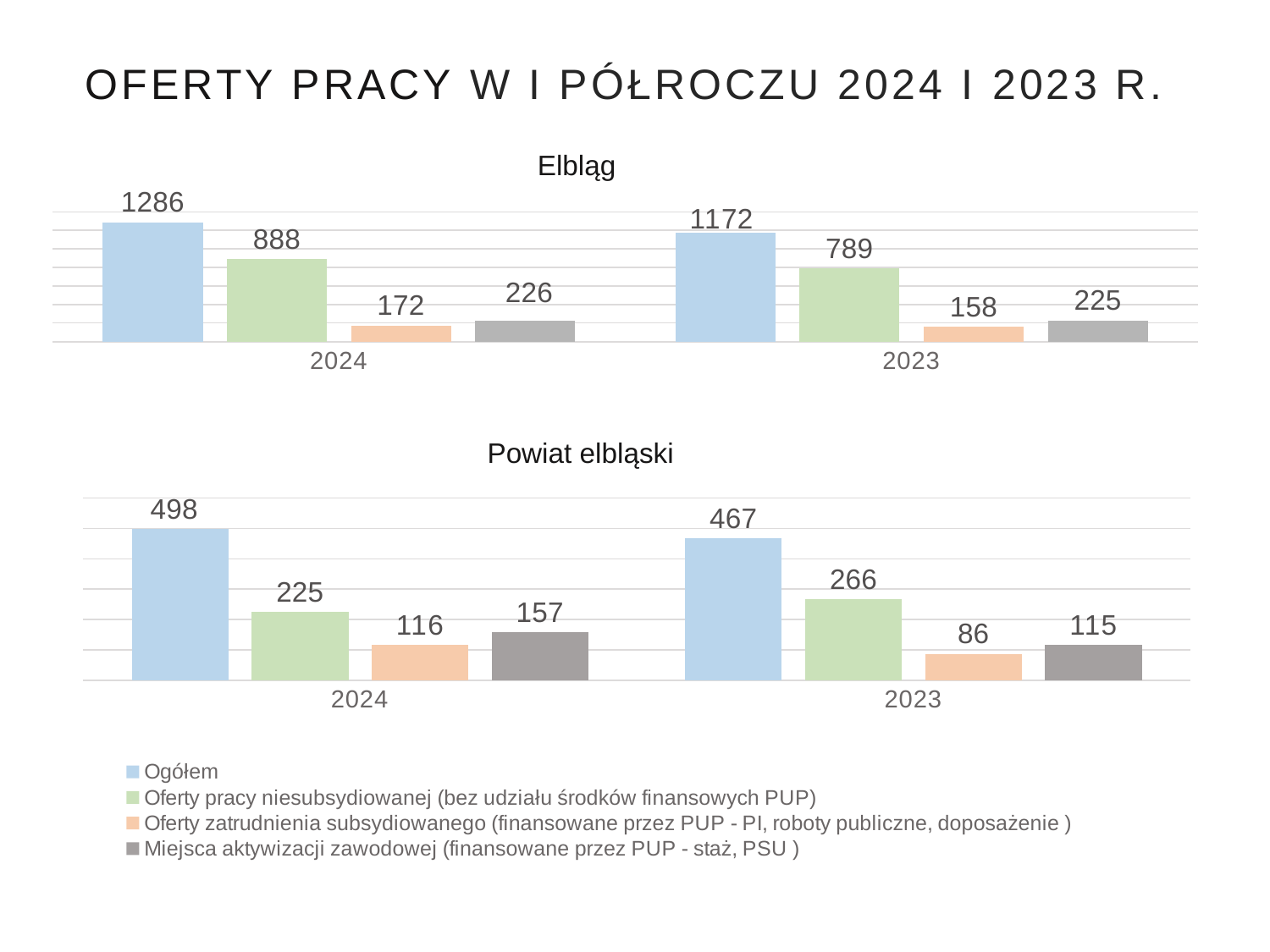
What is the title of the top chart? Elbląg In the Elbląg chart, is Miejsca aktywizacji zawodowej larger in 2024 or in 2023? 2024 How many series does the legend list? 4 In the Elbląg chart, what is the value of Ogółem for 2024? 1286 In the Elbląg chart, what is the difference between Ogółem in 2024 and Ogółem in 2023? 114 In the Powiat elbląski chart, what is the difference between Oferty pracy niesubsydiowanej in 2023 and in 2024? 41 In the Powiat elbląski chart, which series has the highest value in 2024? Ogółem In the Elbląg chart, what is the value of Oferty pracy niesubsydiowanej for 2023? 789 What type of chart is the Powiat elbląski chart? Bar chart In the Elbląg chart, which series has the lowest value in 2023? Oferty zatrudnienia subsydiowanego In the Powiat elbląski chart, what is the value of Miejsca aktywizacji zawodowej for 2024? 157 In the Powiat elbląski chart, what is the value of Oferty zatrudnienia subsydiowanego for 2023? 86